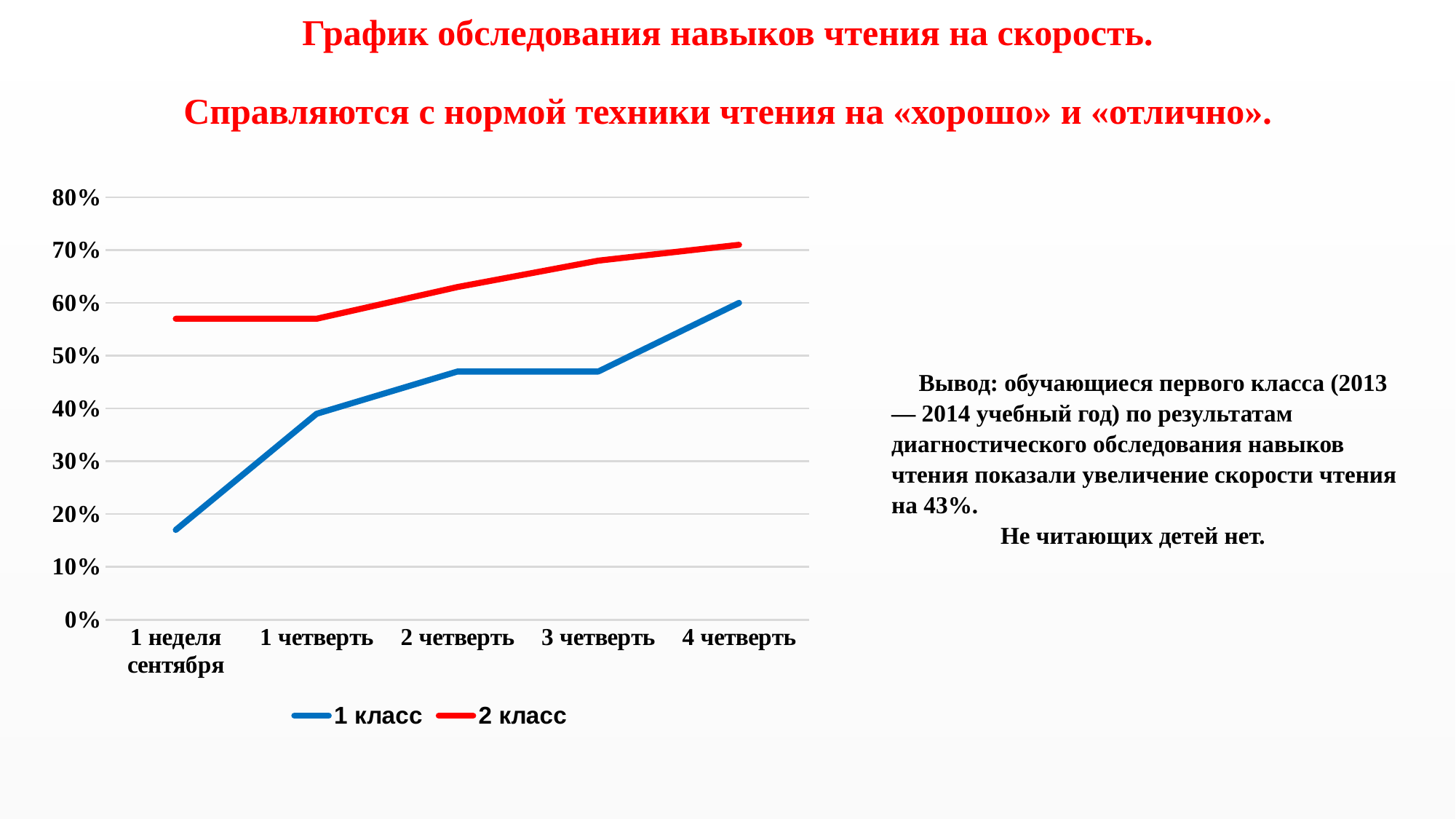
How many series does the legend list? 2 Does the value for 1 класс rise or fall from 1 неделя сентября to 4 четверть? rise Is the value for 1 класс at 1 неделя сентября greater or less than 20%? less Which colour is used for the 2 класс line? red Is the value for 1 класс at 2 четверть greater or less than 50%? less Does the value for 2 класс rise or fall from 1 неделя сентября to 4 четверть? rise How many points along the x axis does each line have? 5 What kind of chart is shown on the slide? line chart At which point on the x axis is the value for 1 класс lowest? 1 неделя сентября Which series has the higher value at 4 четверть, 1 класс or 2 класс? 2 класс Which series has the higher value at 1 неделя сентября, 1 класс or 2 класс? 2 класс